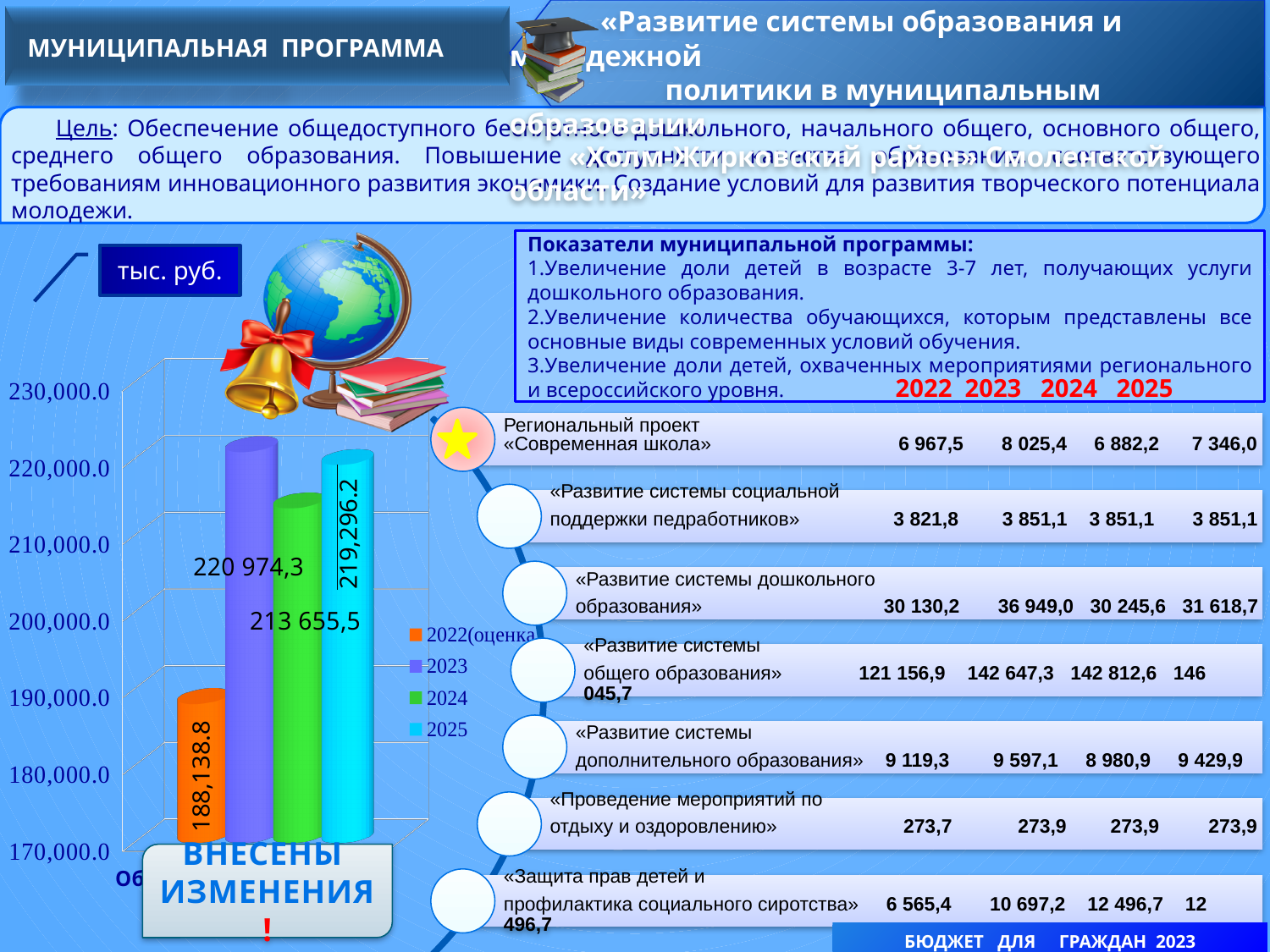
How many entries does the legend of the bar chart list? 4 How many bars are plotted in the bar chart? 4 Which is larger in the bar chart, the value for 2024 or the value for 2025? 2025 Which year has the highest value in the bar chart? 2023 Which year has the lowest value in the bar chart? 2022(оценка) What is the value for 2022(оценка) in the bar chart? 188,138.8 What is the value for 2025 in the bar chart? 219,296.2 Is the value for 2022(оценка) in the bar chart greater or less than 190,000.0? less In what units are the values of the bar chart given, according to the label above it? тыс. руб. What is the value for 2023 in the bar chart? 220 974,3 What type of chart is shown on the left of the slide? bar chart What is the value for 2024 in the bar chart? 213 655,5